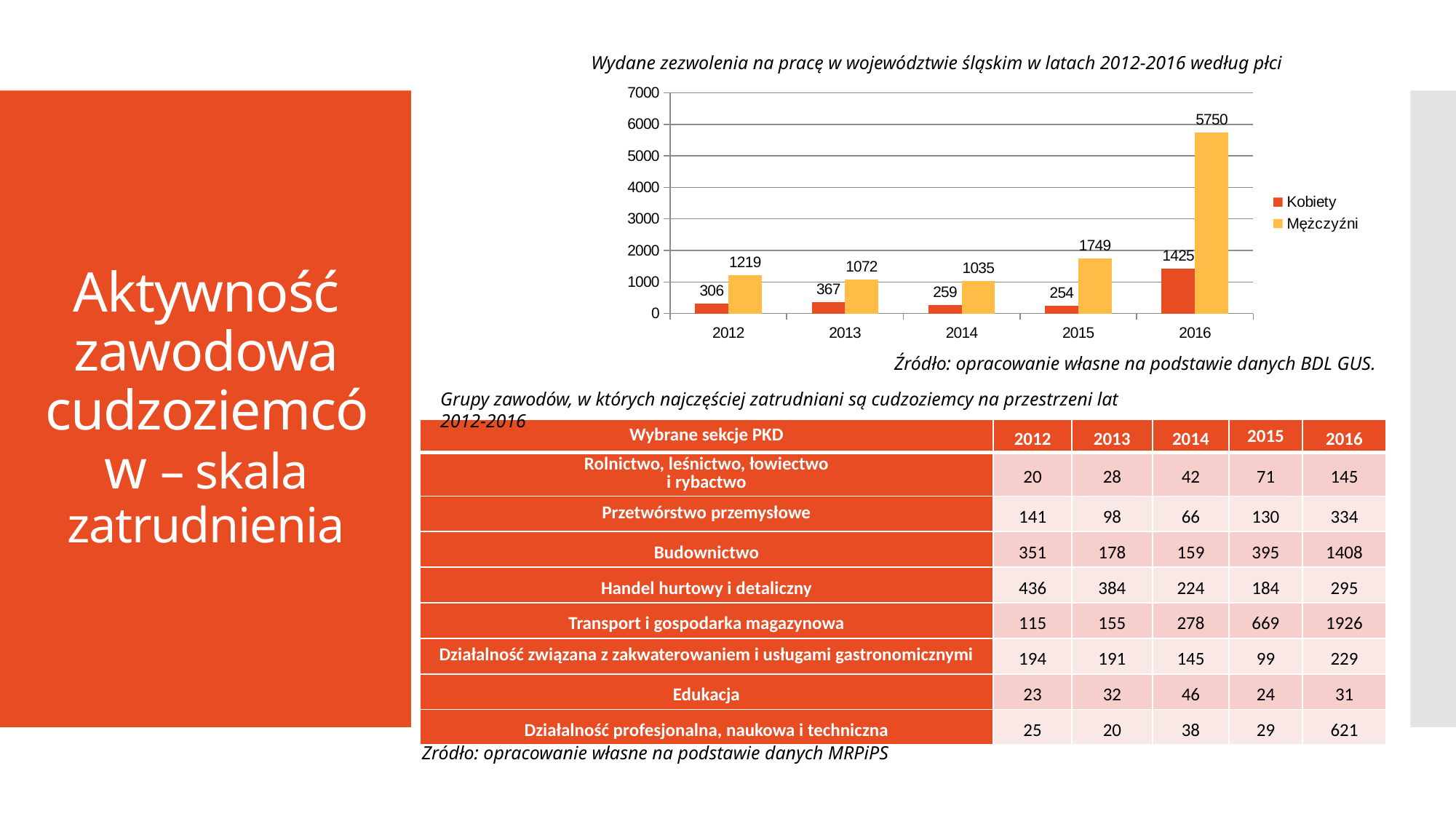
What is the value for Mężczyźni in 2014? 1035 In which year is the value for Mężczyźni the lowest? 2014 Is the value for Mężczyźni in 2016 greater or less than 5000? greater In which year is the value for Kobiety the highest? 2016 What is the value for Mężczyźni in 2016? 5750 What kind of chart is shown on the slide? bar chart Which is larger in 2012: the value for Kobiety or for Mężczyźni? Mężczyźni What is the difference between the Mężczyźni and Kobiety values in 2015? 1495 What is the value for Kobiety in 2013? 367 What is the total of the Kobiety and Mężczyźni values in 2016? 7175 How many years are shown on the x axis of the chart? 5 How many series does the chart legend list? 2